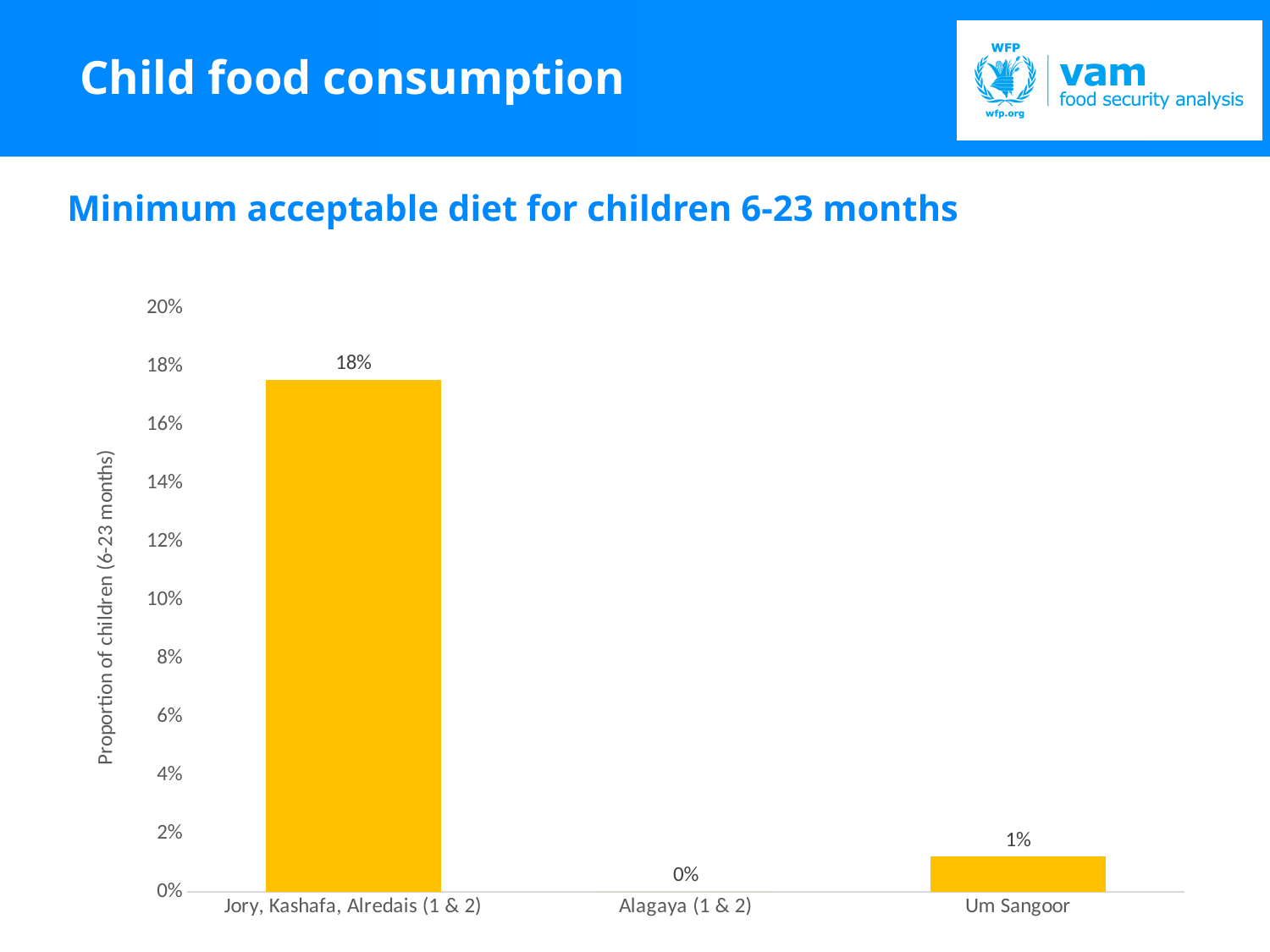
What is the value for Um Sangoor? 1% Which is larger, the value for Um Sangoor or the value for Alagaya (1 & 2)? Um Sangoor Is the value for Jory, Kashafa, Alredais (1 & 2) greater or less than 10%? greater What is the label of the vertical axis? Proportion of children (6-23 months) What kind of chart is shown on the slide? bar chart What is the difference between the values for Jory, Kashafa, Alredais (1 & 2) and Um Sangoor? 17% Which category has the highest value? Jory, Kashafa, Alredais (1 & 2) What is the value for Jory, Kashafa, Alredais (1 & 2)? 18% How many categories are shown on the x axis? 3 Which category has the lowest value? Alagaya (1 & 2) What is the title of the chart? Minimum acceptable diet for children 6-23 months What is the value for Alagaya (1 & 2)? 0%